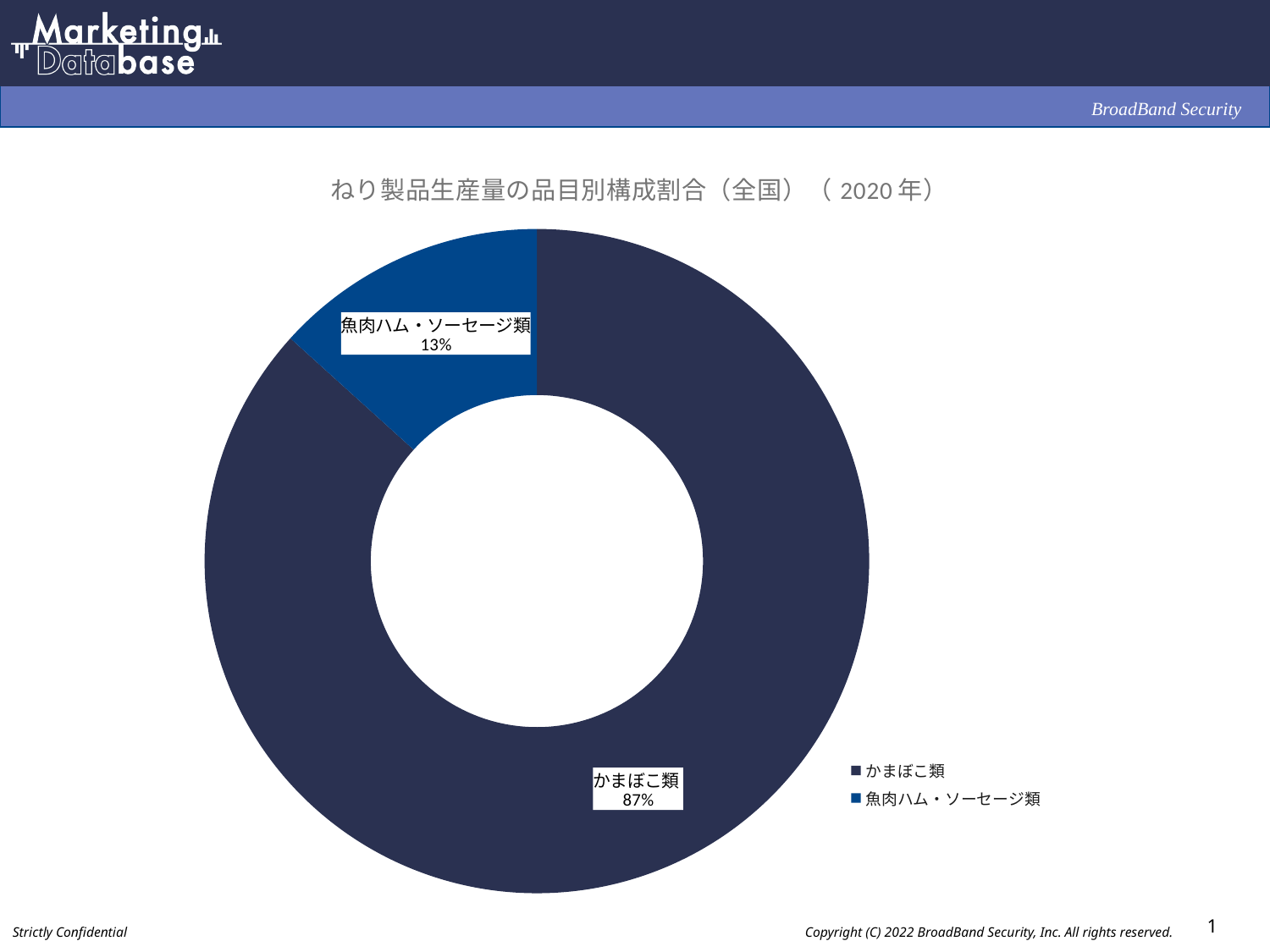
What kind of chart is shown on the slide? Doughnut (pie) chart Which year does the chart's data refer to? 2020年 What is the combined share of かまぼこ類 and 魚肉ハム・ソーセージ類? 100% How many entries does the legend list? 2 What share of the pie does かまぼこ類 account for? 87% Which category has the smallest share of the chart? 魚肉ハム・ソーセージ類 What share of the pie does 魚肉ハム・ソーセージ類 account for? 13% Which category has the largest share of the chart? かまぼこ類 Which is larger, the share of かまぼこ類 or the share of 魚肉ハム・ソーセージ類? かまぼこ類 What is the title of the chart? ねり製品生産量の品目別構成割合（全国）（2020年） How many categories are shown in the chart? 2 What is the difference in percentage points between the share of かまぼこ類 and the share of 魚肉ハム・ソーセージ類? 74 percentage points